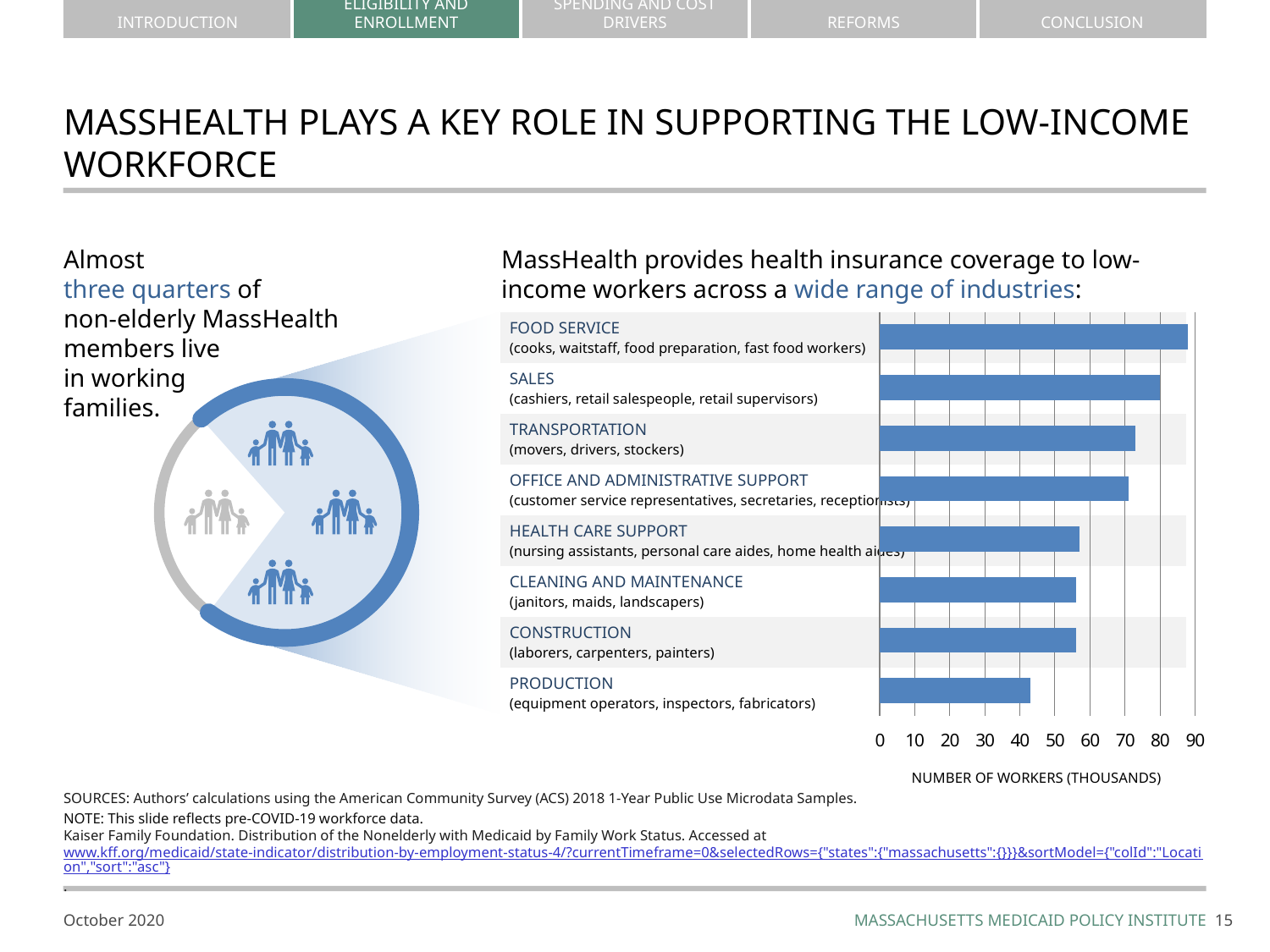
Which has more workers, Production or Office and administrative support? Office and administrative support What kind of chart is shown on the slide? bar chart Is the value for Health care support greater or less than 60? less How many industry categories are plotted in the bar chart? 8 Which industry has the highest number of workers in the bar chart? Food service Is the value for Production greater or less than 50? less Which industry has the lowest number of workers in the bar chart? Production Is the value for Food service greater or less than 80? greater Which has more workers, Sales or Construction? Sales What is the label of the horizontal axis of the bar chart? Number of workers (thousands) What is the highest tick value shown on the horizontal axis of the bar chart? 90